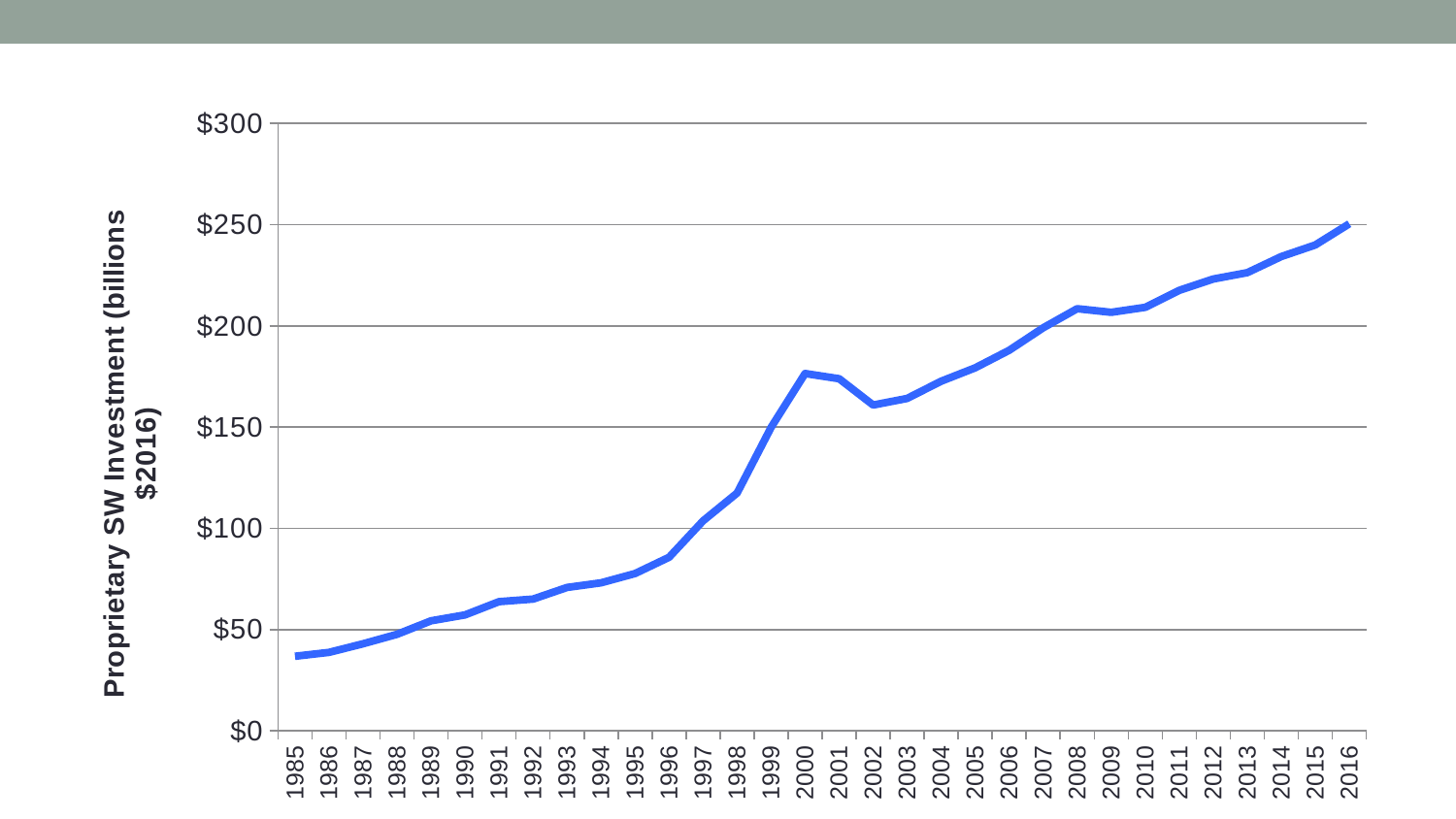
Is the value for 2016 greater or less than $200? greater Which year has the highest Proprietary SW Investment value? 2016 Is the value for 1985 greater or less than $50? less Which year has the larger value, 1990 or 1995? 1995 How many years are plotted along the x axis? 32 Is the value for 1996 greater or less than $100? less What kind of chart is shown on the slide? Line chart Which year has the larger value, 2000 or 2002? 2000 Which year has the lowest Proprietary SW Investment value? 1985 What is the label on the y axis? Proprietary SW Investment (billions $2016) Overall, do the values rise or fall from 1985 to 2016? Rise